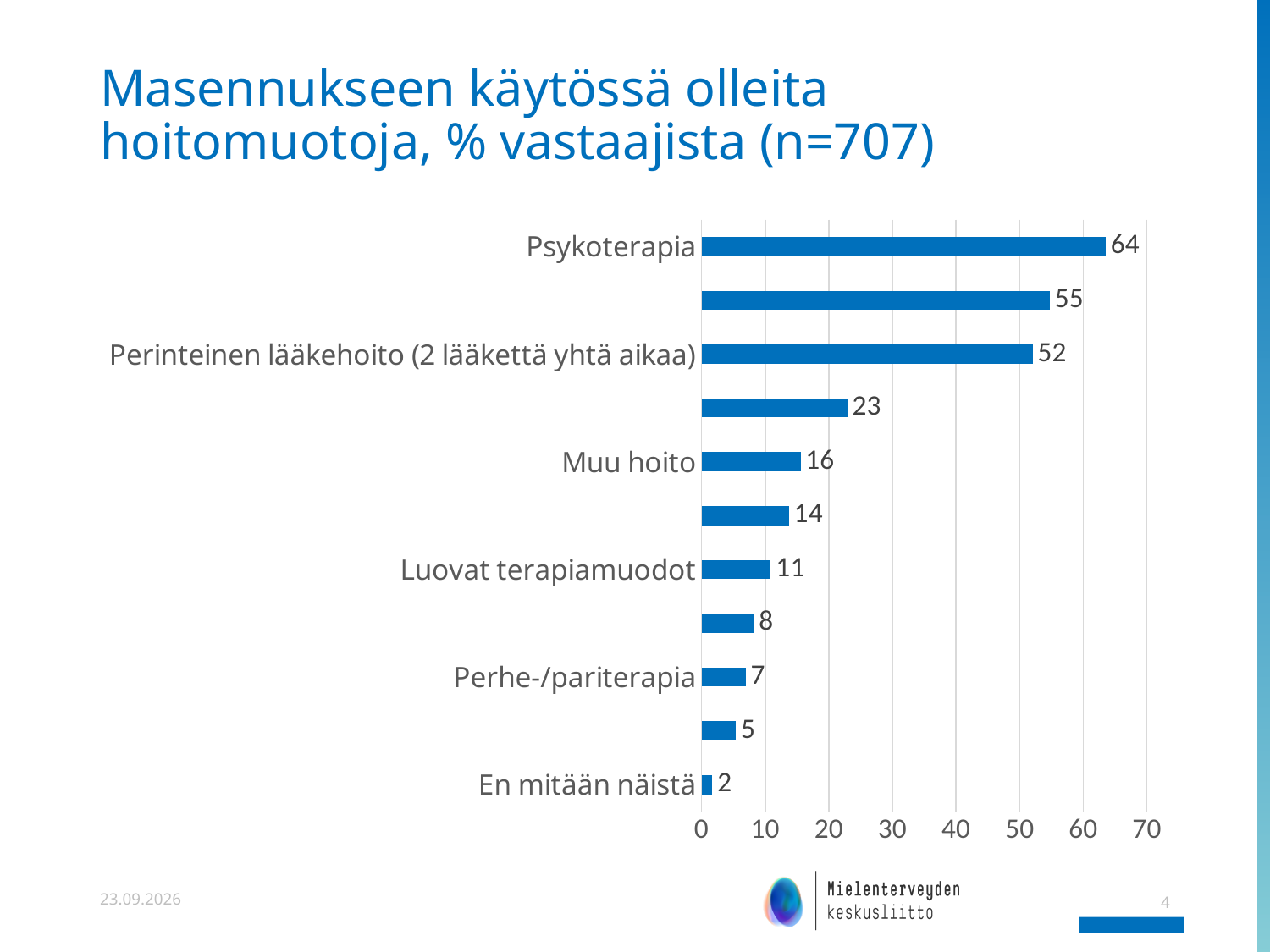
What is the value for Luovat terapiamuodot? 11 What is the value for Perinteinen lääkehoito (2 lääkettä yhtä aikaa)? 52 What is the difference between the values for Psykoterapia and Perinteinen lääkehoito (2 lääkettä yhtä aikaa)? 12 How many bars are plotted in the chart? 11 What is the value for Psykoterapia? 64 What is the value for Muu hoito? 16 What is the value for En mitään näistä? 2 What type of chart is shown on the slide? bar chart Which is larger, the value for Muu hoito or the value for Luovat terapiamuodot? Muu hoito What is the value for Perhe-/pariterapia? 7 Which category has the highest value? Psykoterapia Which category has the lowest value? En mitään näistä